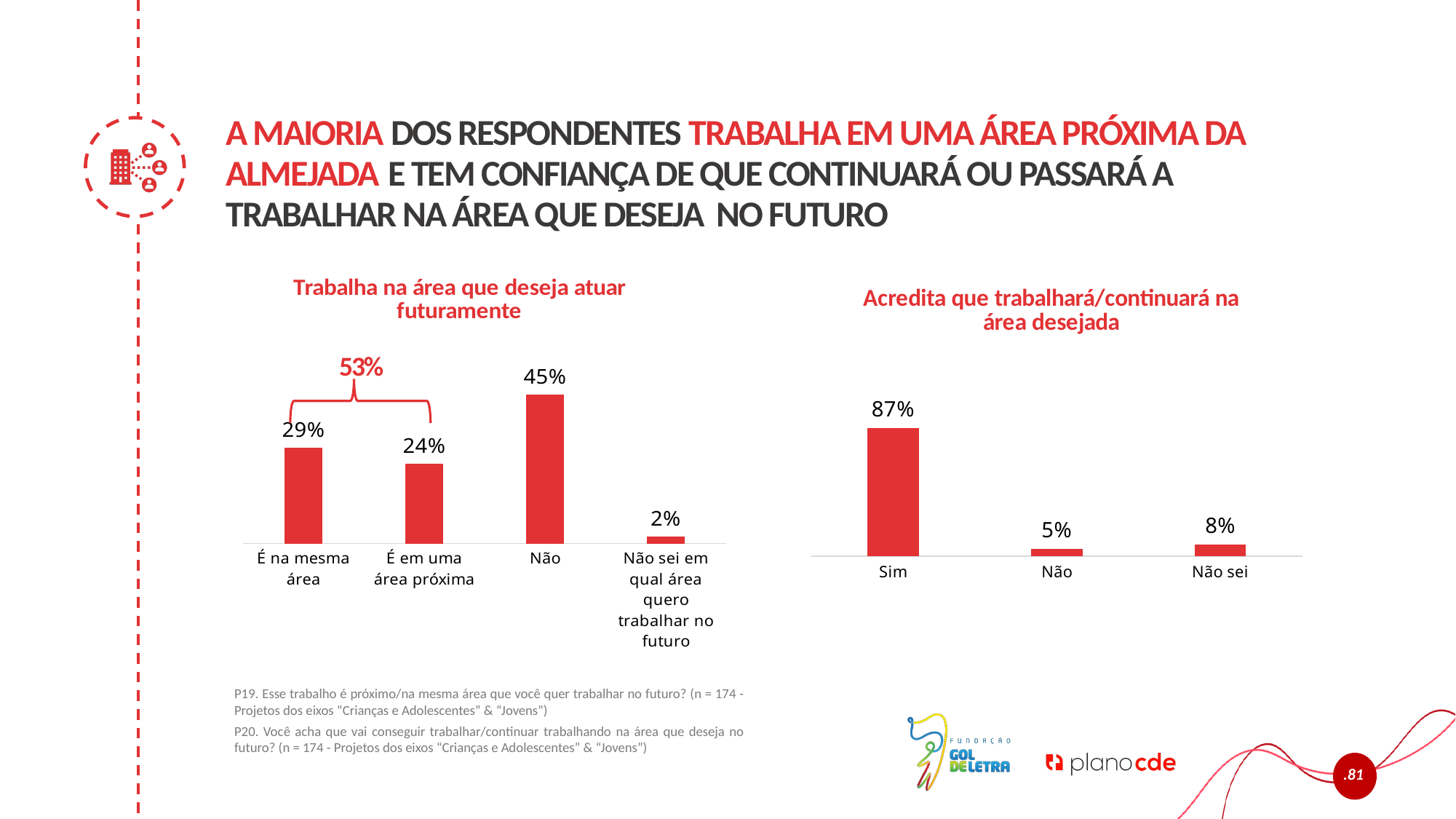
In the chart 'Trabalha na área que deseja atuar futuramente', what combined percentage is shown by the bracket over the first two bars? 53% What type of chart is 'Acredita que trabalhará/continuará na área desejada'? Bar chart In the chart 'Trabalha na área que deseja atuar futuramente', which category has the highest value? Não In the chart 'Trabalha na área que deseja atuar futuramente', which category has the lowest value? Não sei em qual área quero trabalhar no futuro In the chart 'Trabalha na área que deseja atuar futuramente', what is the difference between 'É na mesma área' and 'É em uma área próxima'? 5% In the chart 'Acredita que trabalhará/continuará na área desejada', what is the value for 'Sim'? 87% In the chart 'Acredita que trabalhará/continuará na área desejada', which is larger, 'Não' or 'Não sei'? Não sei In the chart 'Acredita que trabalhará/continuará na área desejada', what is the value for 'Não sei'? 8% In the chart 'Trabalha na área que deseja atuar futuramente', what is the value for 'Não'? 45% How many categories are shown in the chart 'Trabalha na área que deseja atuar futuramente'? 4 In the chart 'Acredita que trabalhará/continuará na área desejada', what is the difference between 'Sim' and 'Não'? 82% In the chart 'Trabalha na área que deseja atuar futuramente', what is the value for 'É na mesma área'? 29%